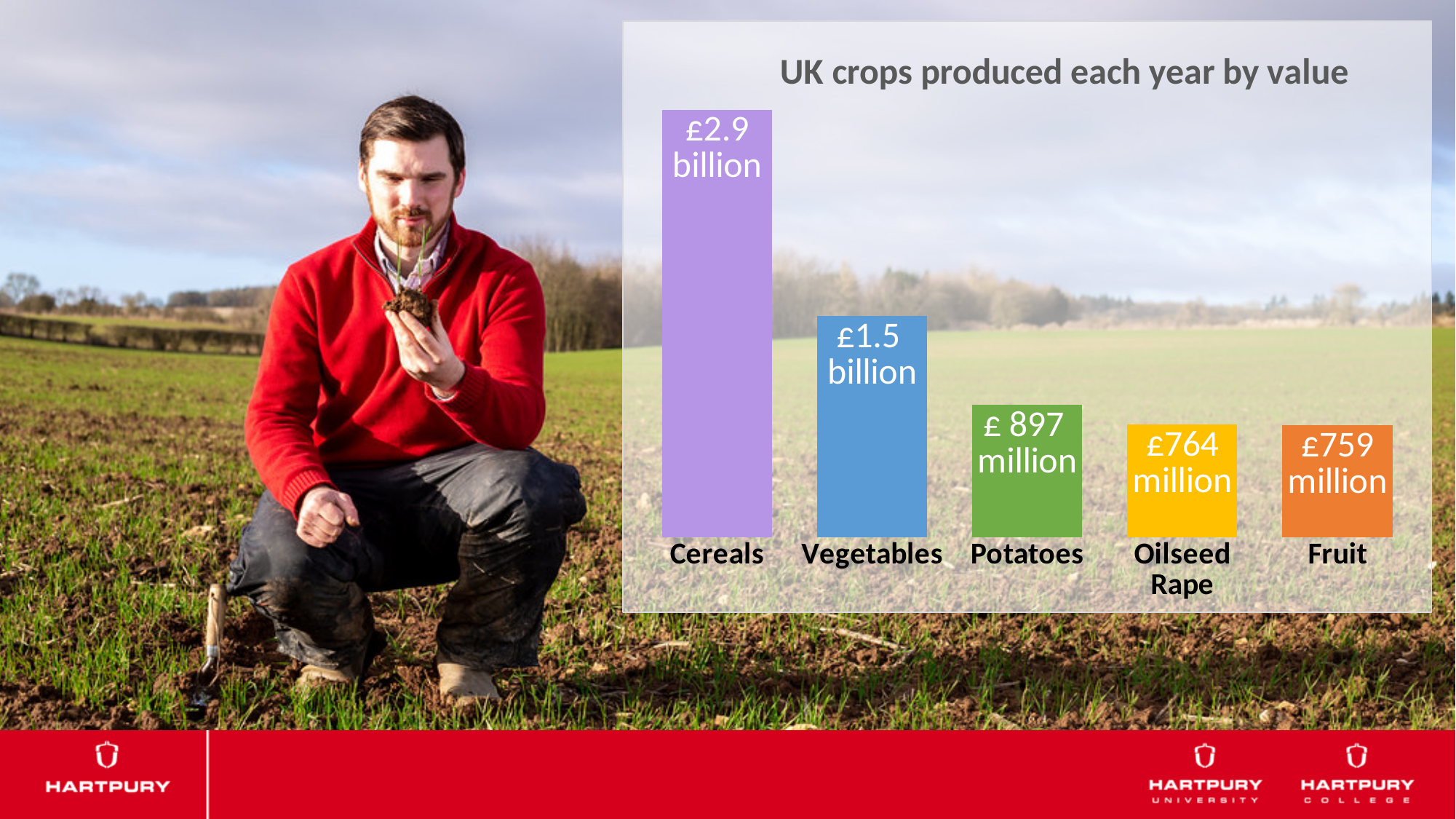
Which crop has the lowest value in the chart? Fruit What is the value of cereals produced each year in the UK according to the chart? £2.9 billion Which has a higher value, vegetables or potatoes? Vegetables What is the value shown for vegetables? £1.5 billion How many crop categories are shown in the chart? 5 What is the value shown for potatoes? £897 million Which crop has the highest value in the chart? Cereals What is the difference in value between potatoes and oilseed rape? £133 million What is the value shown for oilseed rape? £764 million What is the value shown for fruit? £759 million What type of chart is shown on the slide? Bar chart What is the title of the chart? UK crops produced each year by value